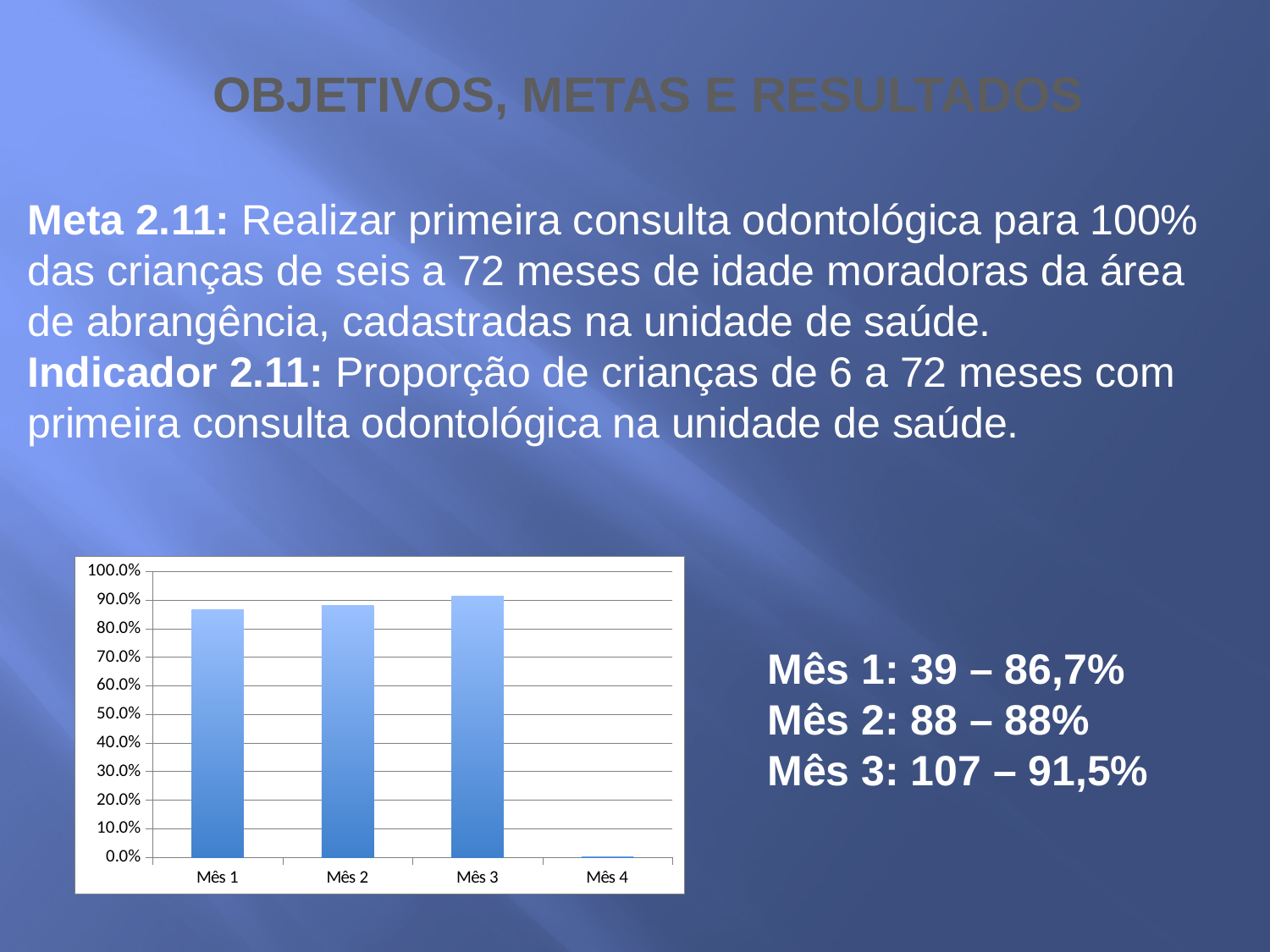
Do the values rise or fall from Mês 1 to Mês 3? rise Which month has the lowest bar in the chart? Mês 4 According to the text beside the chart, what is the proportion for Mês 1? 86,7% Is the value for Mês 4 greater or less than 10.0%? less Is the value for Mês 3 greater or less than 90.0%? greater Is the value for Mês 2 greater or less than 90.0%? less How many categories (months) are shown on the x axis of the chart? 4 Which is larger, the value for Mês 3 or the value for Mês 1? Mês 3 According to the text beside the chart, what is the proportion for Mês 3? 91,5% What type of chart is shown on the slide? bar chart Which month has the highest bar in the chart? Mês 3